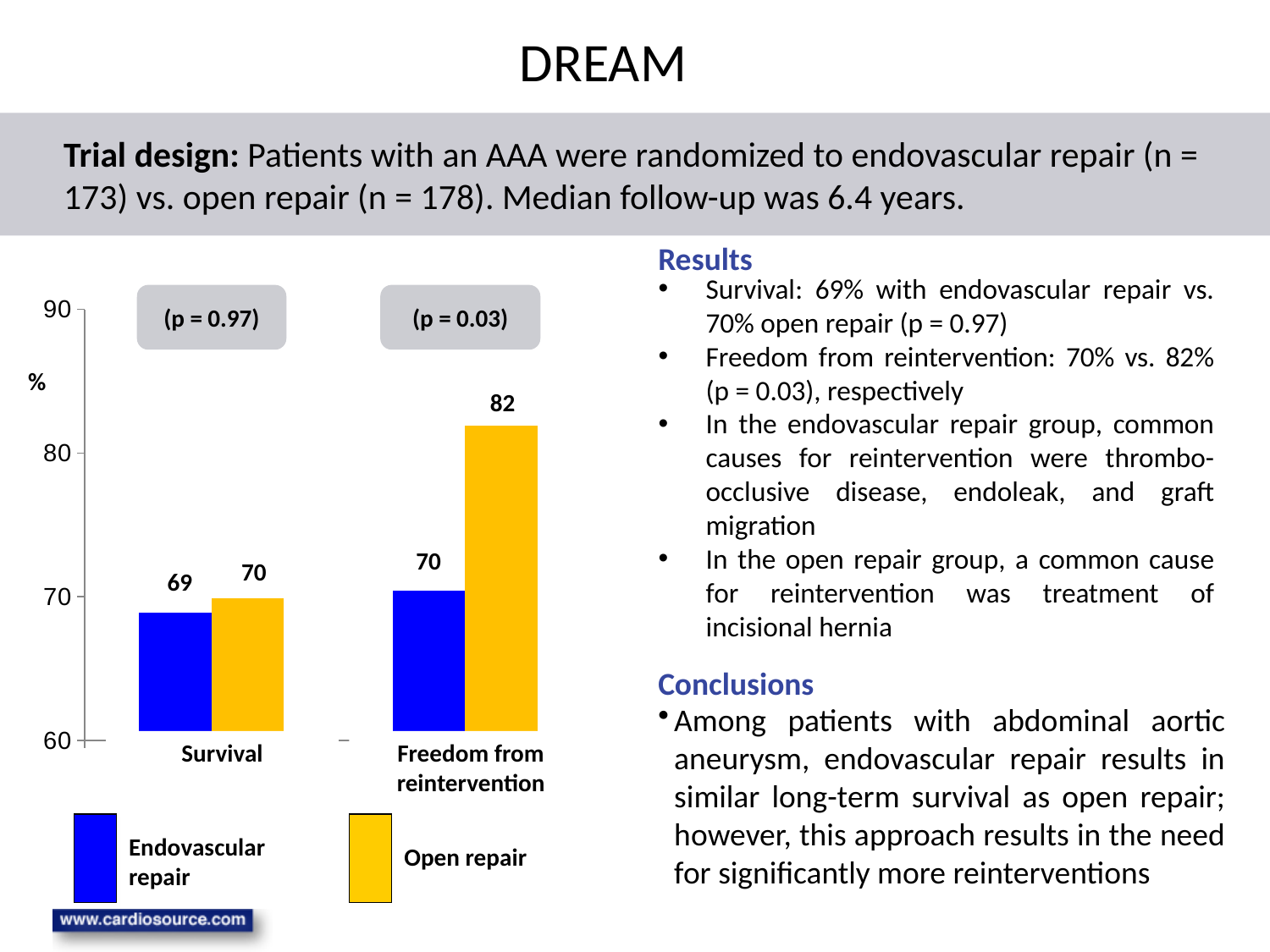
What is the survival value for open repair? 70 What is the difference between open repair and endovascular repair for freedom from reintervention? 12 What colour represents open repair in the chart? Yellow Which bar has the highest value on the chart? Open repair, Freedom from reintervention How many series does the legend list? 2 What is the freedom from reintervention value for endovascular repair? 70 Is the open repair value for freedom from reintervention greater or less than 80? greater What is the survival value for endovascular repair? 69 How many categories are shown on the x axis? 2 For freedom from reintervention, which is larger: endovascular repair or open repair? Open repair What is the freedom from reintervention value for open repair? 82 What kind of chart is shown on the slide? Bar chart